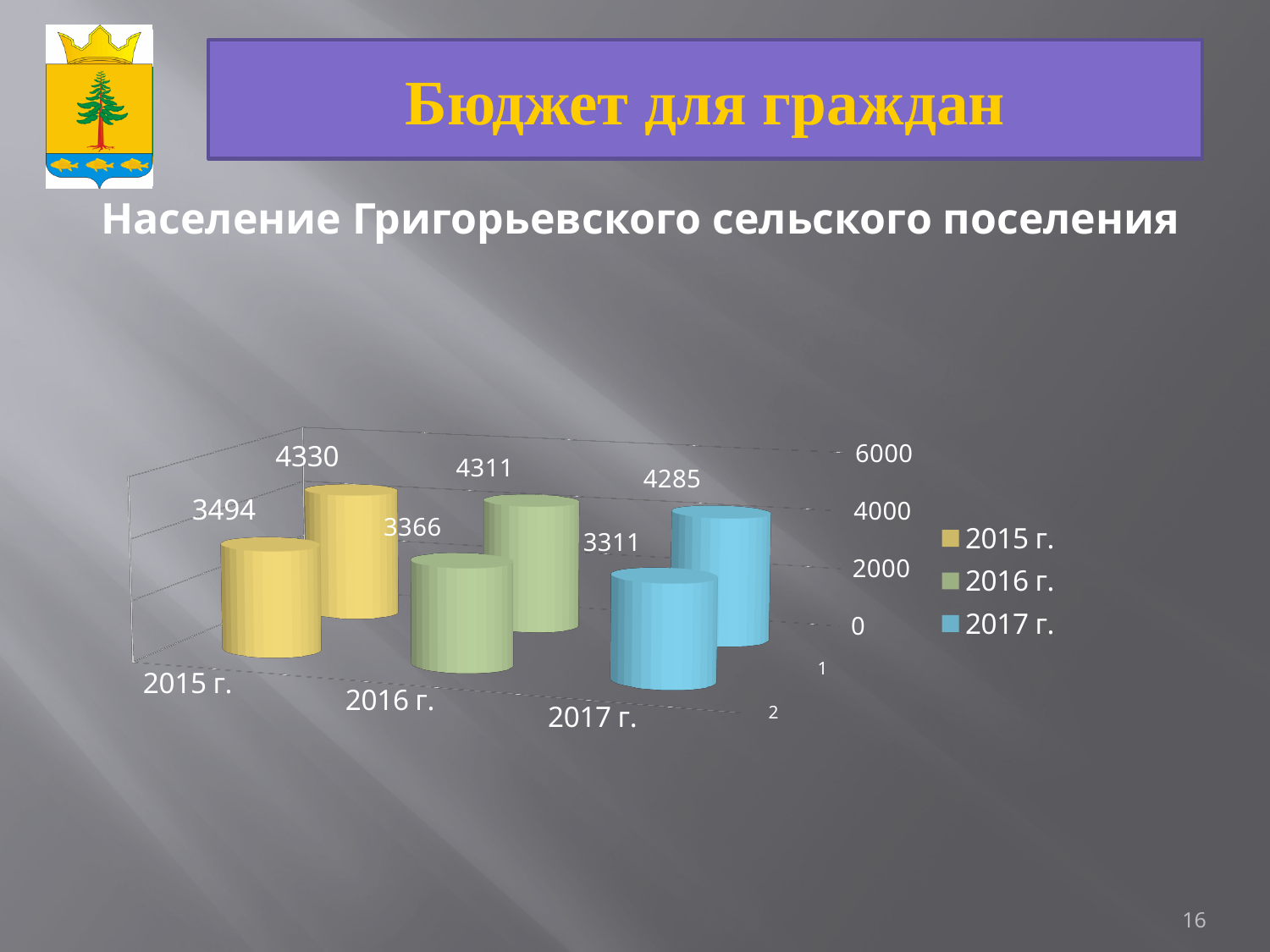
Do the front bar values rise or fall from 2015 г. to 2017 г.? fall What colour are the bars for the 2017 г. series? blue How many series does the chart legend list? 3 What kind of chart is shown on the slide? bar chart What is the value of the first (front) bar for the 2015 г. series? 3494 Which series has the lowest labelled value on the chart? 2017 г. What is the value of the second (back) bar for the 2015 г. series? 4330 Which is larger: the back bar of 2016 г. or the back bar of 2017 г.? 2016 г. What is the value of the second (back) bar for the 2017 г. series? 4285 Which series has the highest labelled value on the chart? 2015 г. What is the difference between the front bar values of 2015 г. (3494) and 2017 г. (3311)? 183 What is the value of the first (front) bar for the 2016 г. series? 3366